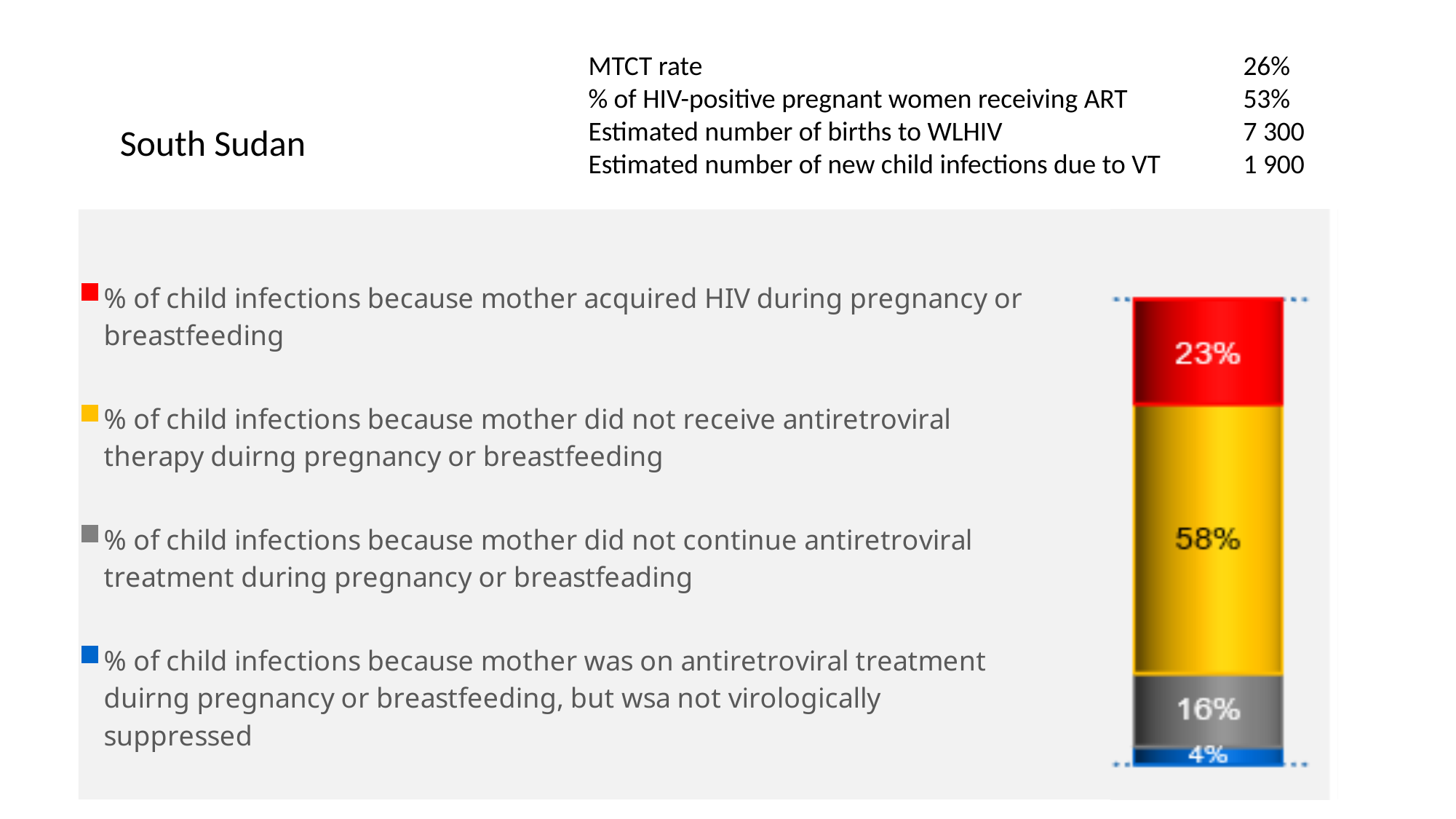
Which is larger: the share for mother acquiring HIV during pregnancy or breastfeeding, or the share for mother not continuing antiretroviral treatment? Mother acquiring HIV during pregnancy or breastfeeding What kind of chart is shown on the slide? Stacked bar chart What is the difference between the share for mother not receiving antiretroviral therapy and the share for mother acquiring HIV during pregnancy or breastfeeding? 35% What percentage of child infections is attributed to the mother being on antiretroviral treatment but not virologically suppressed? 4% What percentage of child infections is attributed to the mother acquiring HIV during pregnancy or breastfeeding? 23% What percentage of child infections is attributed to the mother not receiving antiretroviral therapy during pregnancy or breastfeeding? 58% How many segments make up the stacked bar? 4 What colour is the segment representing child infections because the mother did not receive antiretroviral therapy? Yellow How many series does the legend list? 4 Which cause accounts for the smallest share of child infections in the stacked bar? Mother was on antiretroviral treatment but was not virologically suppressed What percentage of child infections is attributed to the mother not continuing antiretroviral treatment during pregnancy or breastfeeding? 16% Which cause accounts for the largest share of child infections in the stacked bar? Mother did not receive antiretroviral therapy during pregnancy or breastfeeding